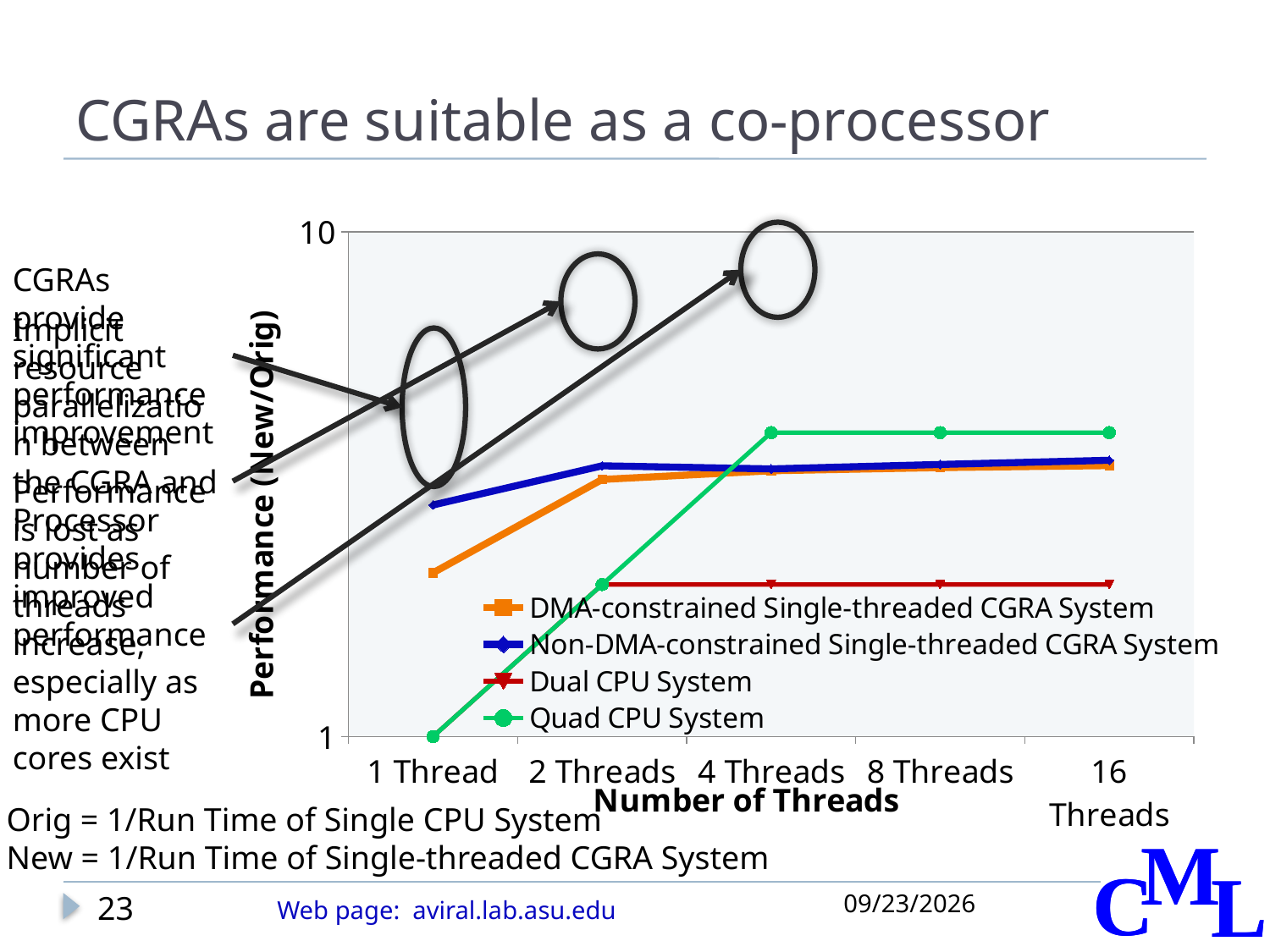
What is the title of the y axis? Performance (New/Orig) What is the performance value of the Quad CPU System at 1 Thread? 1 Which series has the highest performance at 16 Threads? Quad CPU System Does the performance of the Quad CPU System rise or fall from 1 Thread to 4 Threads? rise At 2 Threads, which is higher: the Non-DMA-constrained Single-threaded CGRA System or the DMA-constrained Single-threaded CGRA System? Non-DMA-constrained Single-threaded CGRA System At 4 Threads, which is higher: the Quad CPU System or the Dual CPU System? Quad CPU System What is the title of the x axis? Number of Threads How many series does the legend list? 4 Is the value for the Quad CPU System at 16 Threads greater or less than 10? less How many thread-count categories are shown on the x axis? 5 Which series has the lowest performance at 16 Threads? Dual CPU System What kind of chart is shown on the slide? line chart